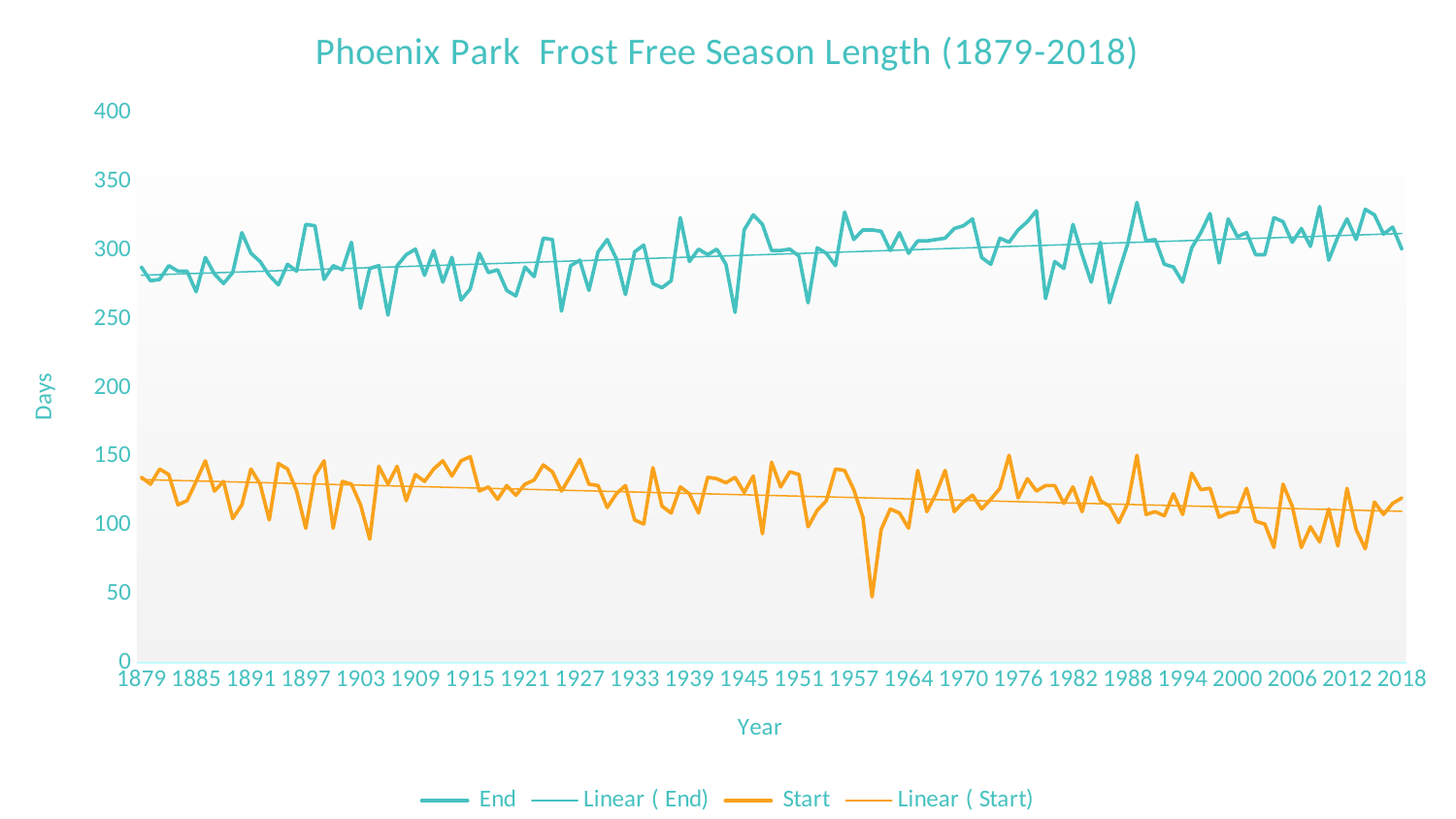
Does the Start series generally rise or fall from 1879 to 2018? Fall Does the End series generally rise or fall from 1879 to 2018? Rise Is the value for Start in 2018 greater or less than 150? less What kind of chart is shown on the slide? Line chart What is the title of the chart? Phoenix Park Frost Free Season Length (1879-2018) Is the value for Start in 1879 greater or less than 100? greater How many entries does the legend list? 4 Is the lowest value of the Start series greater or less than 100? less What is the label on the vertical axis? Days Which series has the larger value in 2018, End or Start? End